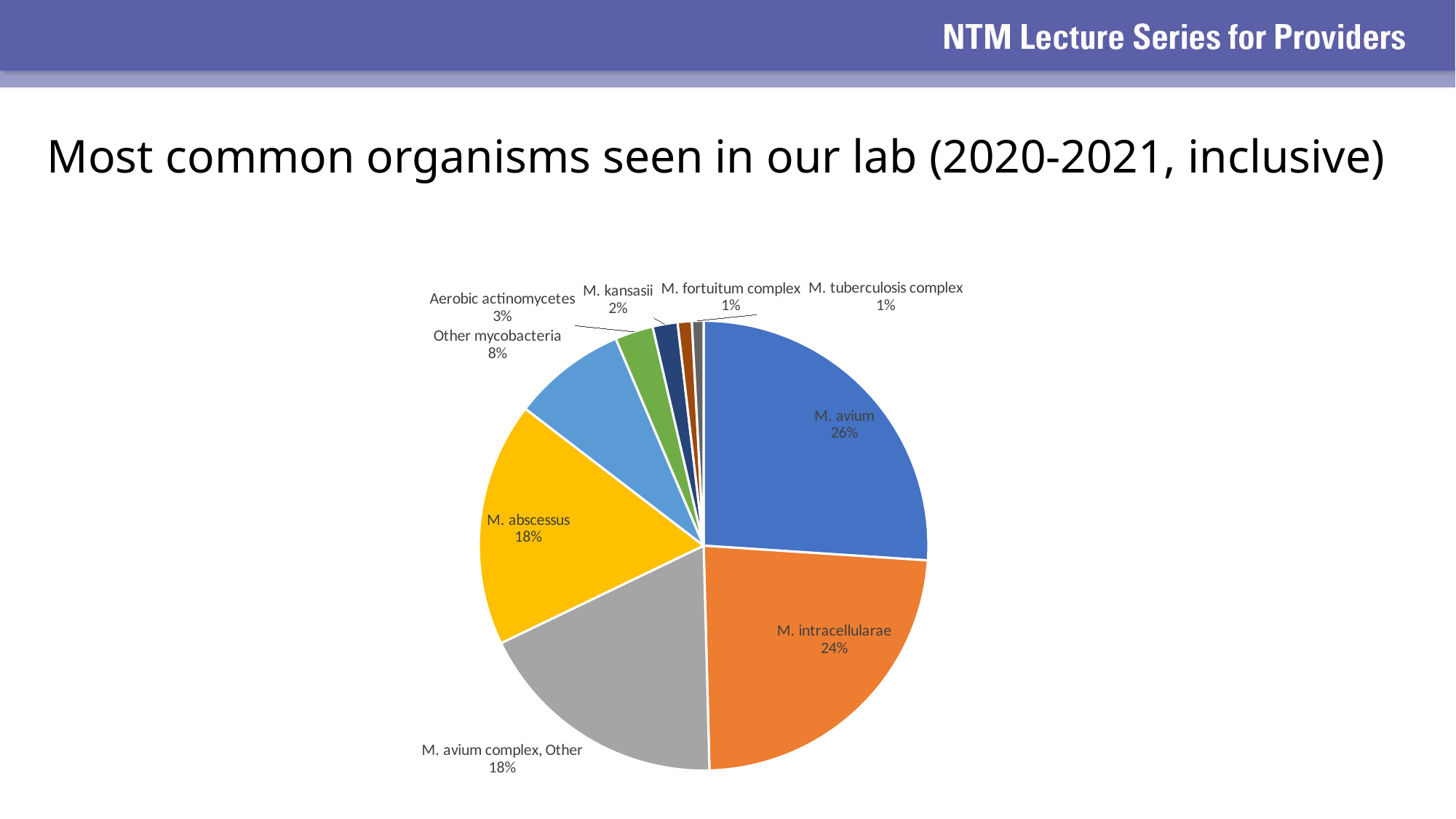
What is the title of the slide containing the chart? Most common organisms seen in our lab (2020-2021, inclusive) What percentage is shown for M. kansasii? 2% How many categories (slices) are shown in the pie chart? 9 What is the difference in percentage points between M. abscessus and Aerobic actinomycetes? 15 What percentage is shown for Other mycobacteria? 8% What is the difference in percentage points between M. avium and M. intracellularae? 2 What percentage is shown for Aerobic actinomycetes? 3% Which is larger, the share for M. abscessus or the share for Other mycobacteria? M. abscessus What share of the pie does M. avium represent? 26% Which organism has the largest slice of the pie? M. avium What percentage is shown for M. intracellularae? 24% What type of chart is shown on the slide? pie chart